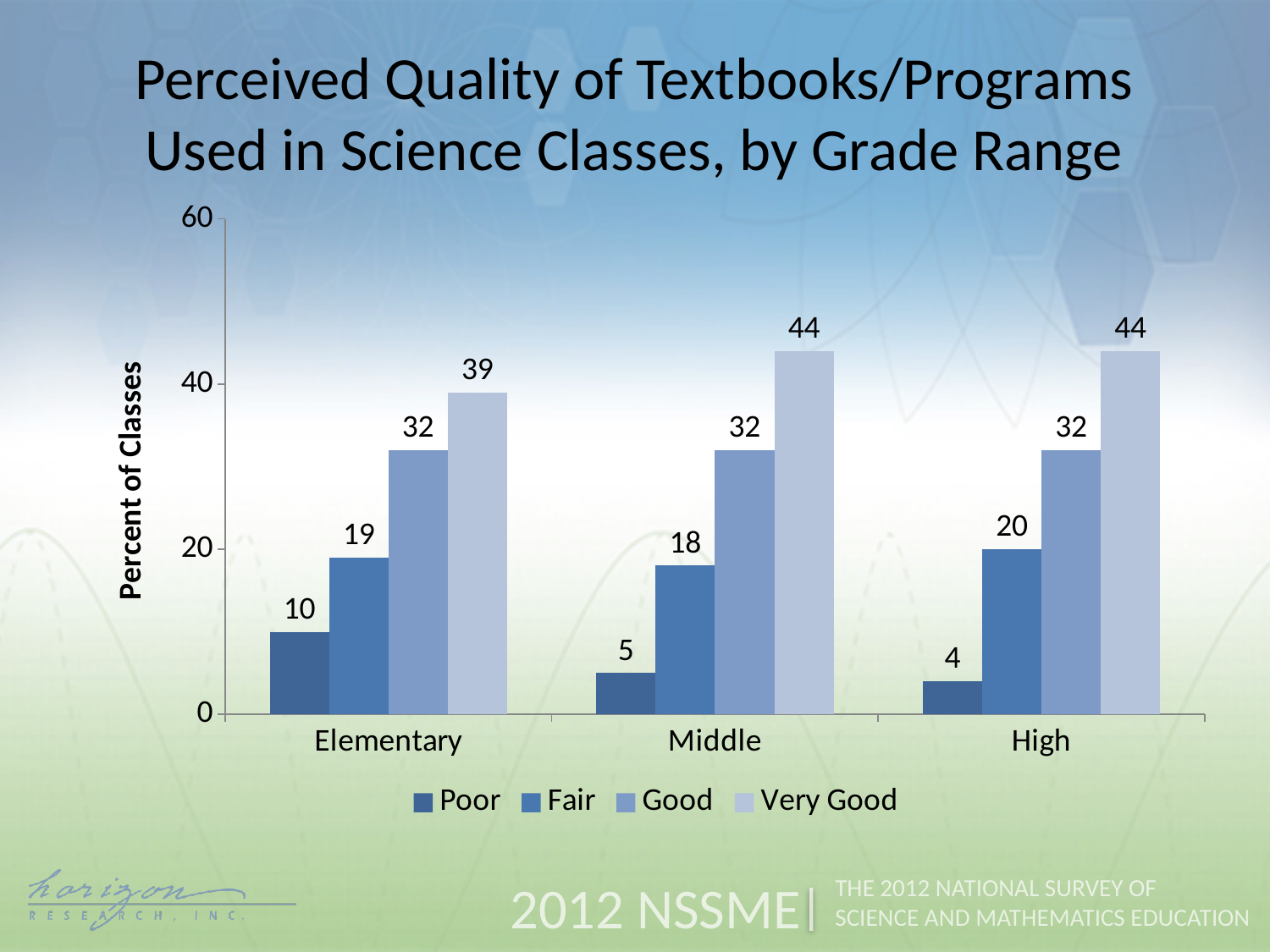
What is the value for Fair in the High grade range? 20 Is the Good value for Middle greater or less than 20? greater What is the difference between the Very Good and Poor values for the Middle grade range? 39 How many series does the legend list? 4 What is the label of the y axis? Percent of Classes What percent of Elementary science classes rated their textbooks/programs as Very Good? 39 Which grade range has the lowest value for Poor? High How many grade ranges are shown on the x axis? 3 Is the Fair value for Elementary larger or smaller than the Fair value for High? smaller What kind of chart is shown on the slide? bar chart What is the value for Poor in the Middle grade range? 5 Which grade range has the highest value for Very Good? Middle and High (tied at 44)